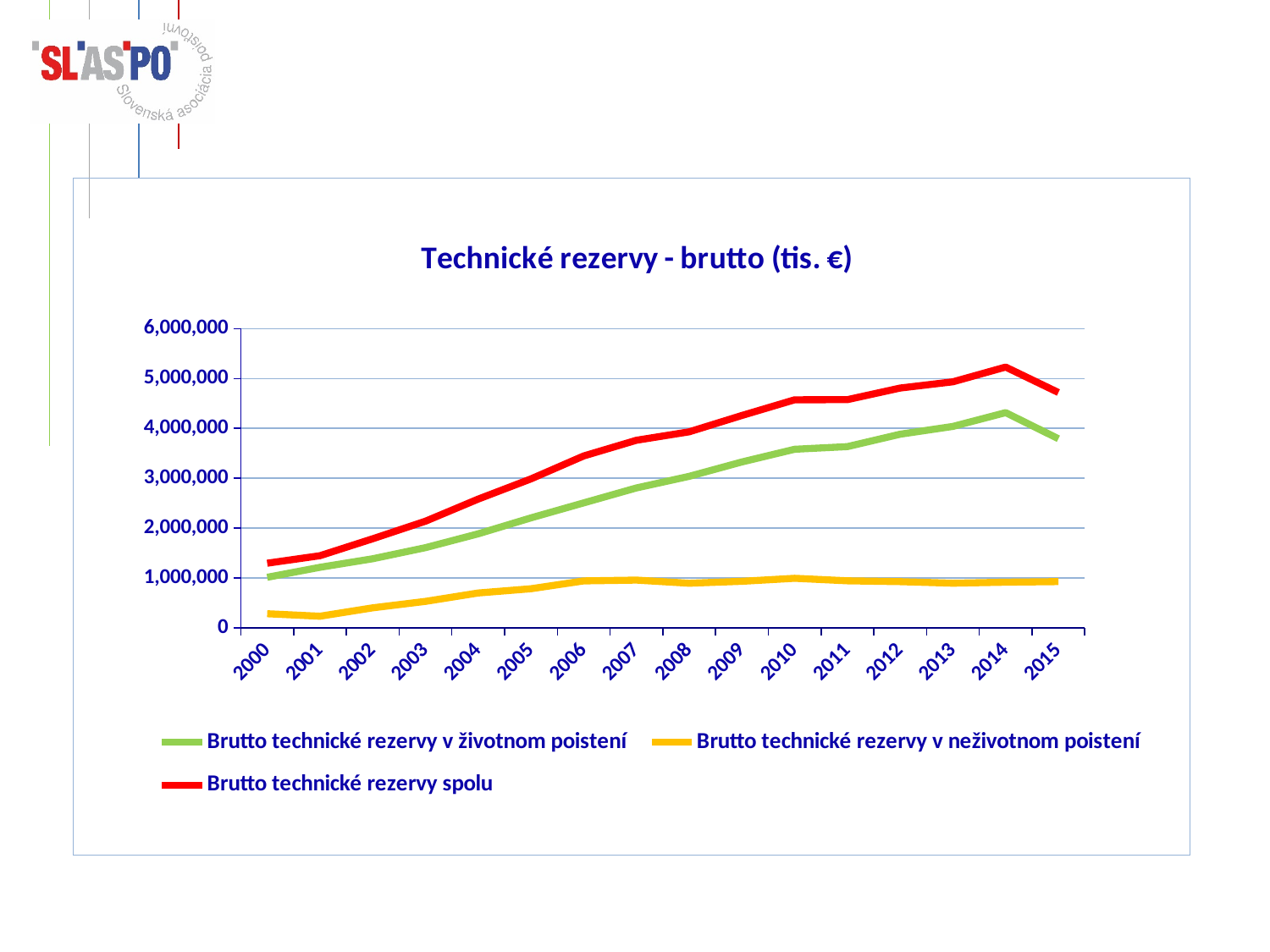
Which series is drawn in red? Brutto technické rezervy spolu What is the title of the chart? Technické rezervy - brutto (tis. €) How many years are shown on the x axis? 16 In which year does the series 'Brutto technické rezervy spolu' reach its highest value? 2014 In which year is the series 'Brutto technické rezervy spolu' at its lowest value? 2000 What kind of chart is shown on the slide? line chart Is the value for 'Brutto technické rezervy spolu' in 2014 greater or less than 5,000,000? greater Is the value for 'Brutto technické rezervy v životnom poistení' in 2015 greater or less than 4,000,000? less Is the value for 'Brutto technické rezervy v neživotnom poistení' in 2000 greater or less than 1,000,000? less Does the series 'Brutto technické rezervy spolu' rise or fall from 2000 to 2014? rise How many series does the legend list? 3 In 2010, which is larger: 'Brutto technické rezervy v životnom poistení' or 'Brutto technické rezervy v neživotnom poistení'? Brutto technické rezervy v životnom poistení